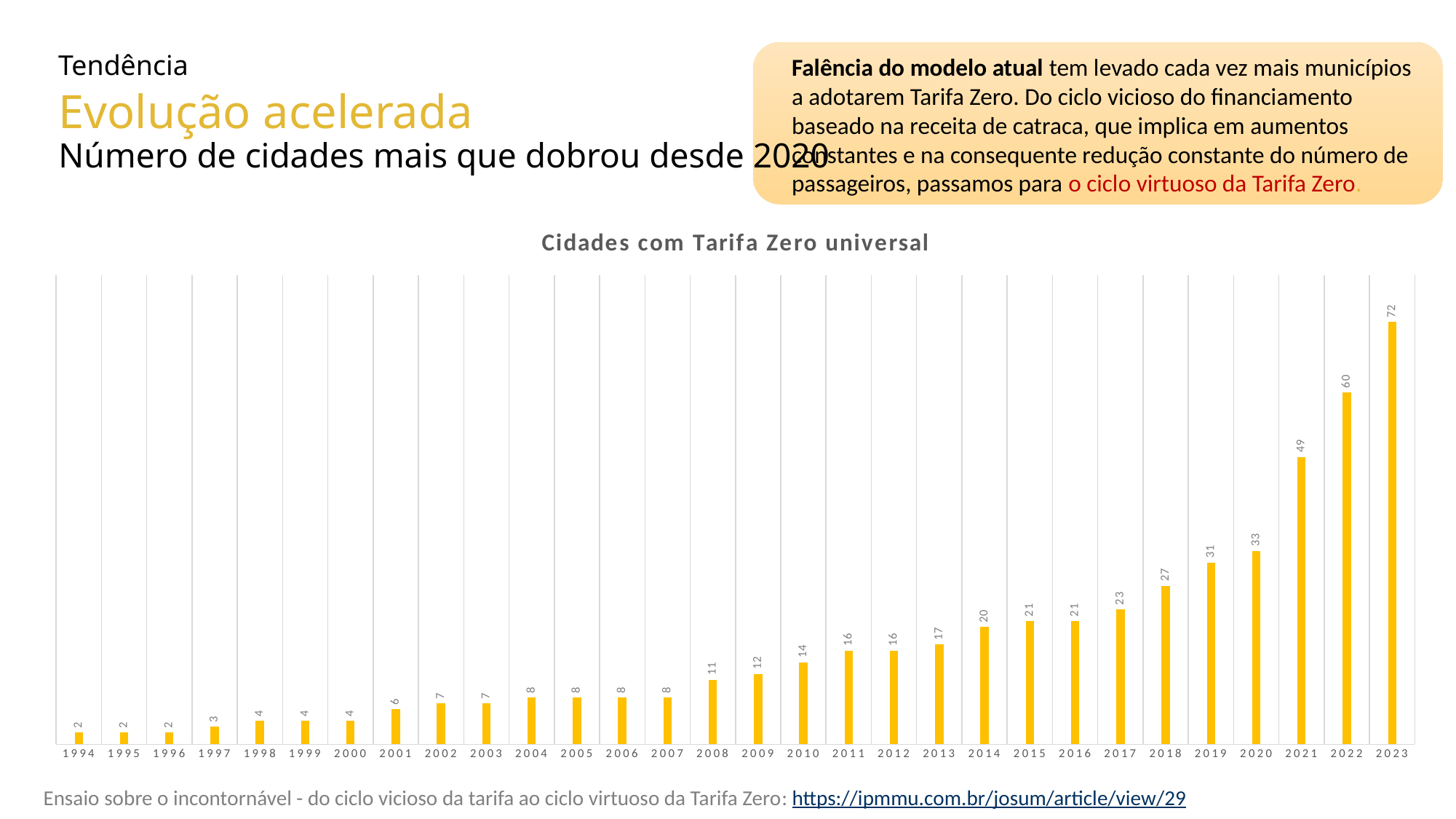
What is the value for 1997? 3 What is the difference between the values for 2023 and 2022? 12 What kind of chart is shown on the slide? bar chart What is the title of the chart? Cidades com Tarifa Zero universal What is the value for 2020? 33 Which year has the highest value? 2023 What is the difference between the values for 2021 and 2020? 16 What is the value for 2023? 72 How many years are shown on the x axis? 30 Do the values generally rise or fall from 1994 to 2023? rise What is the value for 2008? 11 Which is larger, the value for 2018 or the value for 2014? 2018